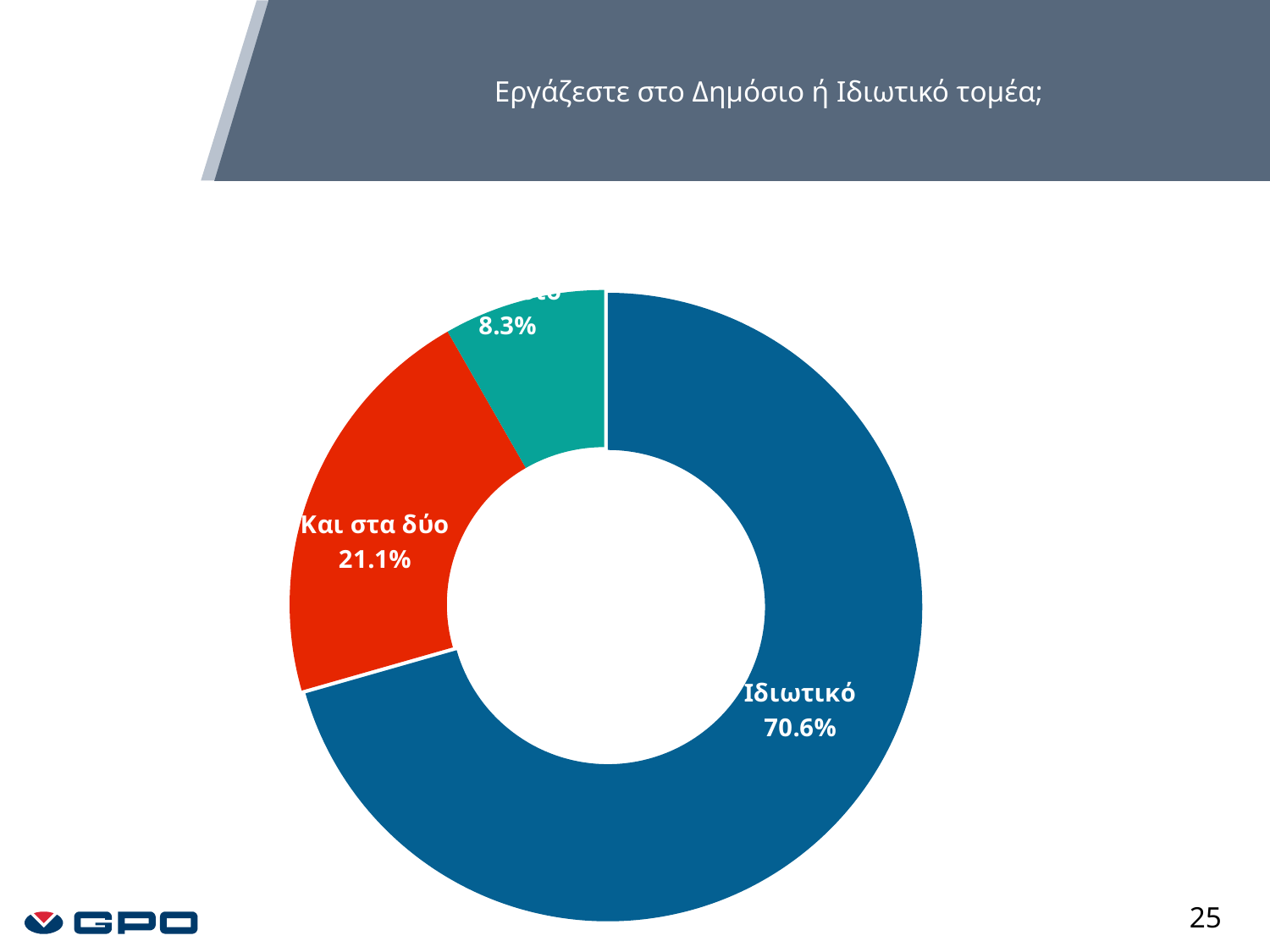
What percentage is shown on the teal slice of the chart? 8.3% What percentage is shown for Ιδιωτικό? 70.6% Which slice of the chart is the smallest? The teal slice (8.3%) What is the title of the chart on the slide? Εργάζεστε στο Δημόσιο ή Ιδιωτικό τομέα; What colour is the slice for Ιδιωτικό? Blue What type of chart is shown on the slide? Donut (pie) chart How many slices does the chart have? 3 Which category has the largest share of the chart? Ιδιωτικό What percentage is shown for Και στα δύο? 21.1% What is the combined share of Και στα δύο and the teal slice? 29.4% Which is larger, the share for Και στα δύο or the share of the teal slice? Και στα δύο What is the difference between the shares of Ιδιωτικό and Και στα δύο? 49.5%